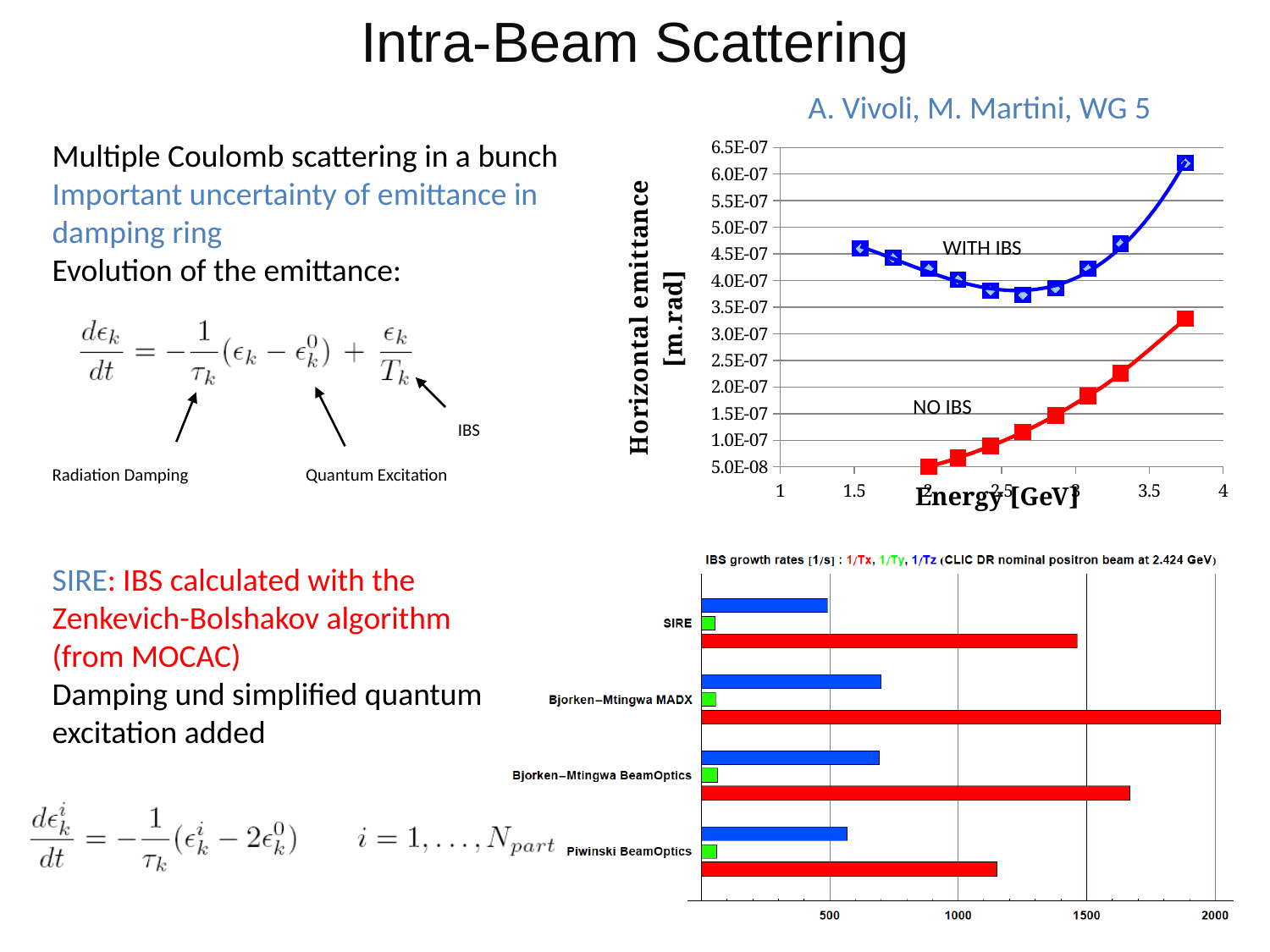
What kind of chart is the bottom-right chart of IBS growth rates? bar chart In the bottom-right IBS growth rates chart, how many categories (methods) are shown? 4 In the top-right emittance chart, is the lowest WITH IBS value greater or less than 4.0E-07? less In the bottom-right IBS growth rates chart, which method has the largest 1/Tx (red) bar? Bjorken-Mtingwa MADX In the top-right emittance chart, is the NO IBS value at the highest energy point greater or less than 3.0E-07? greater In the bottom-right IBS growth rates chart, is the 1/Tx (red) value for SIRE greater or less than 1000? greater In the bottom-right IBS growth rates chart, how many series does the title list? 3 In the top-right emittance chart, how many series are plotted? 2 In the top-right emittance chart, does the NO IBS series rise or fall as energy increases? rise In the bottom-right IBS growth rates chart, which method has the smallest 1/Tx (red) bar? Piwinski BeamOptics What kind of chart is the top-right chart of horizontal emittance versus energy? line chart In the top-right emittance chart, which series has the higher horizontal emittance at 2 GeV, WITH IBS or NO IBS? WITH IBS